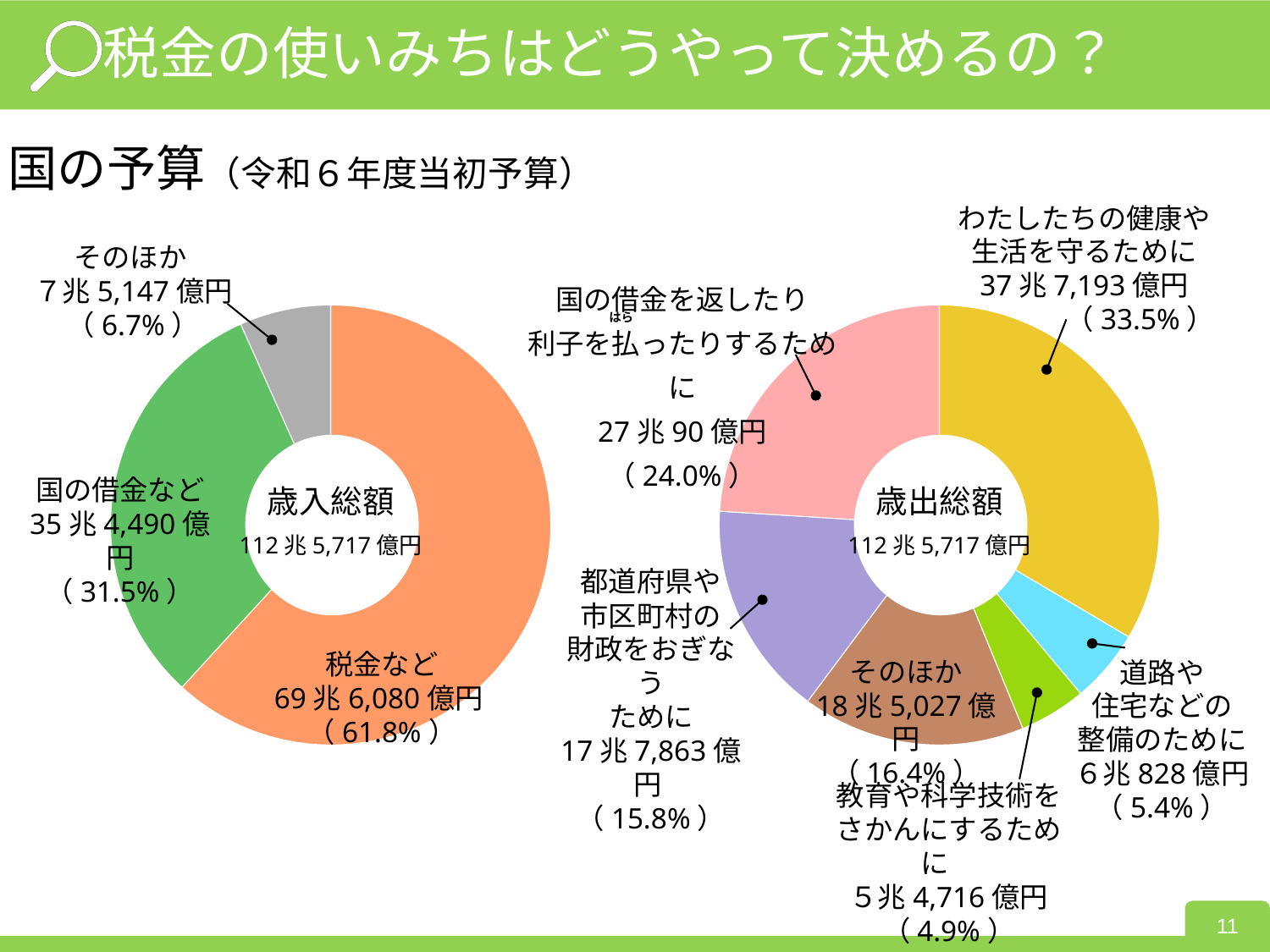
In the 歳出総額 chart on the right, what is the value for わたしたちの健康や生活を守るために? 37兆7,193億円 In the 歳入総額 chart on the left, how many categories are shown? 3 In the 歳入総額 chart on the left, what share of the total is 国の借金など? 31.5% In the 歳入総額 chart on the left, what is the value for 税金など? 69兆6,080億円 In the 歳入総額 chart on the left, which category is the smallest? そのほか In the 歳出総額 chart on the right, what share of the total is 国の借金を返したり利子を払ったりするために? 24.0% What kind of chart is the 歳出総額 chart on the right? Pie (donut) chart In the 歳出総額 chart on the right, how many categories are shown? 6 In the 歳出総額 chart on the right, which category is the largest? わたしたちの健康や生活を守るために In the 歳出総額 chart on the right, which category is the smallest? 教育や科学技術をさかんにするために In the 歳出総額 chart on the right, which is larger: そのほか or 都道府県や市区町村の財政をおぎなうために? そのほか What total is shown in the centre of the 歳入総額 chart on the left? 112兆5,717億円